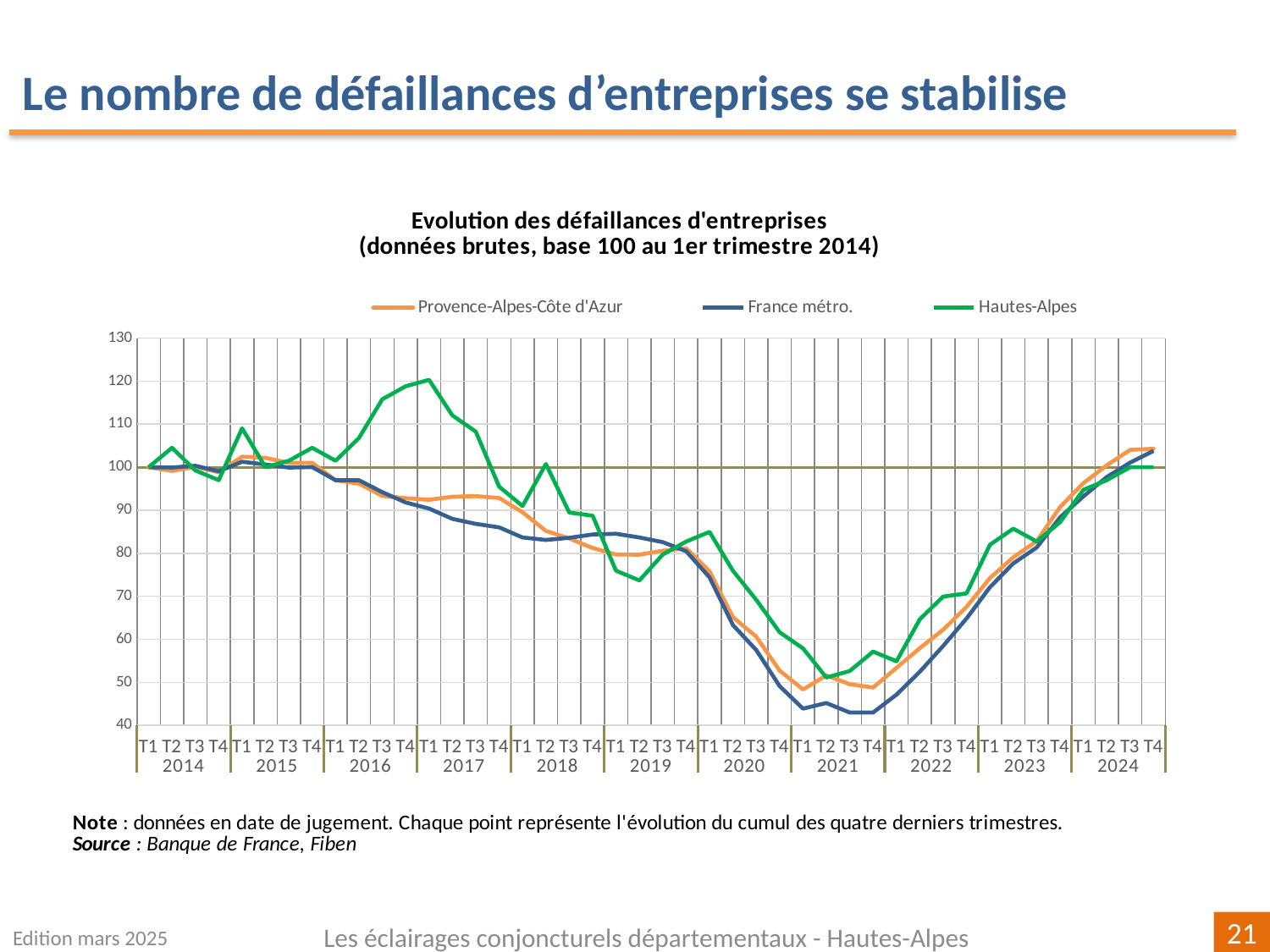
Is the value for France métro. at T1 2021 greater or less than 50? less Is the value for Provence-Alpes-Côte d'Azur at T4 2024 greater or less than 100? greater How many series does the legend list? 3 How many years are shown along the x axis? 11 Is the value for Hautes-Alpes at T1 2017 greater or less than 110? greater Which series reaches the highest value anywhere on the chart? Hautes-Alpes What kind of chart is shown on the slide? line chart What colour is the Hautes-Alpes line in the legend? green Which series reaches the lowest value anywhere on the chart? France métro. Between T1 2020 and T1 2021, does the France métro. line rise or fall? fall At T1 2017, which is higher: Hautes-Alpes or France métro.? Hautes-Alpes